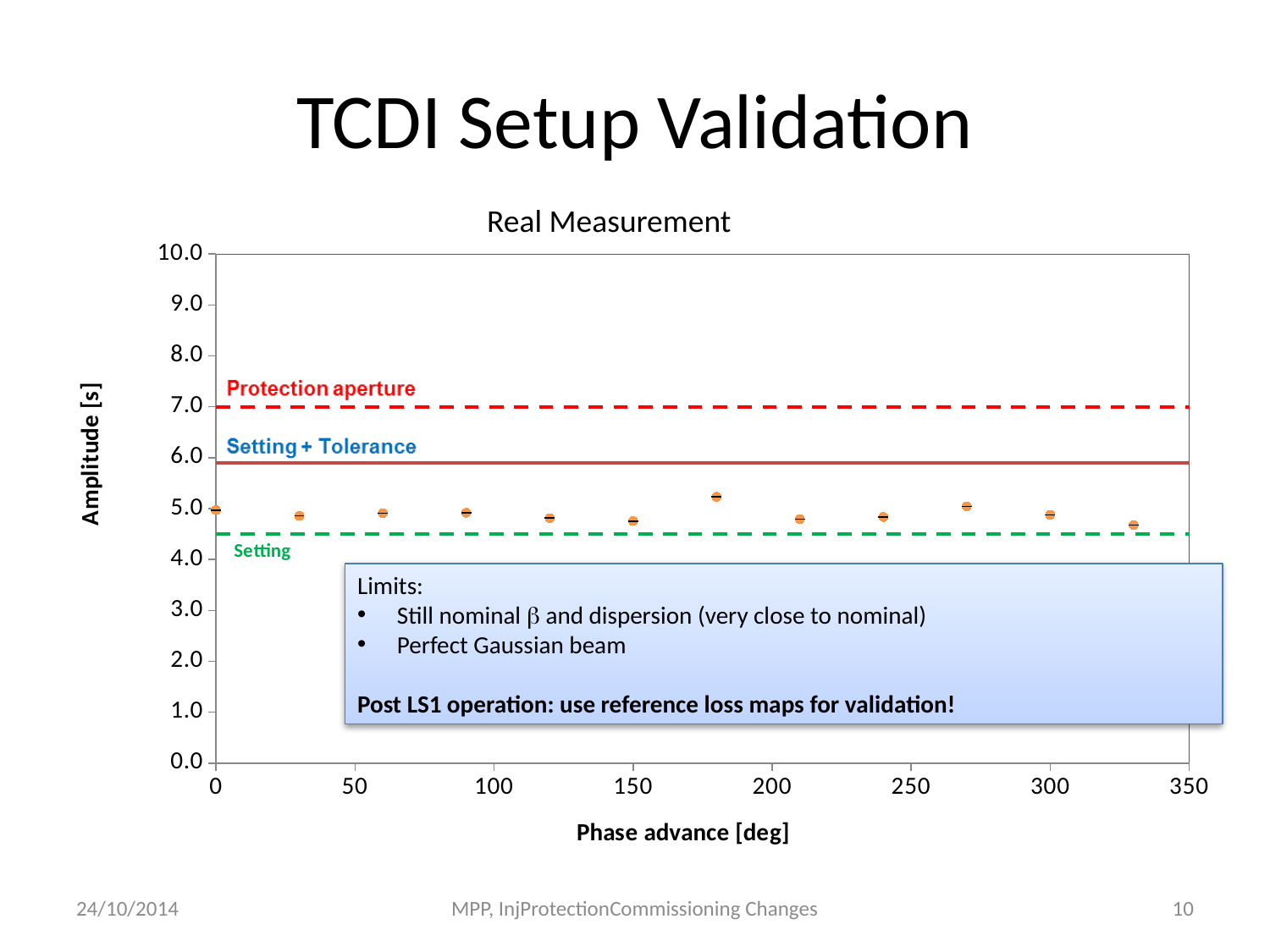
Is the measured amplitude at a phase advance of 150 deg greater or less than 5.0? less What is the title of the chart? Real Measurement How many measured data points are plotted in the chart? 12 At what amplitude is the Protection aperture line drawn? 7.0 What is the label of the x axis? Phase advance [deg] Is the measured amplitude at a phase advance of 180 deg greater or less than 5.0? greater Is the measured amplitude at a phase advance of 330 deg greater or less than 5.0? less Which has the larger measured amplitude: the point at 180 deg or the point at 330 deg? 180 deg What kind of chart is shown on the slide? scatter chart At which phase advance is the measured amplitude highest? 180 Do the measured amplitudes show a clear rising or falling trend with phase advance, or stay roughly flat? roughly flat